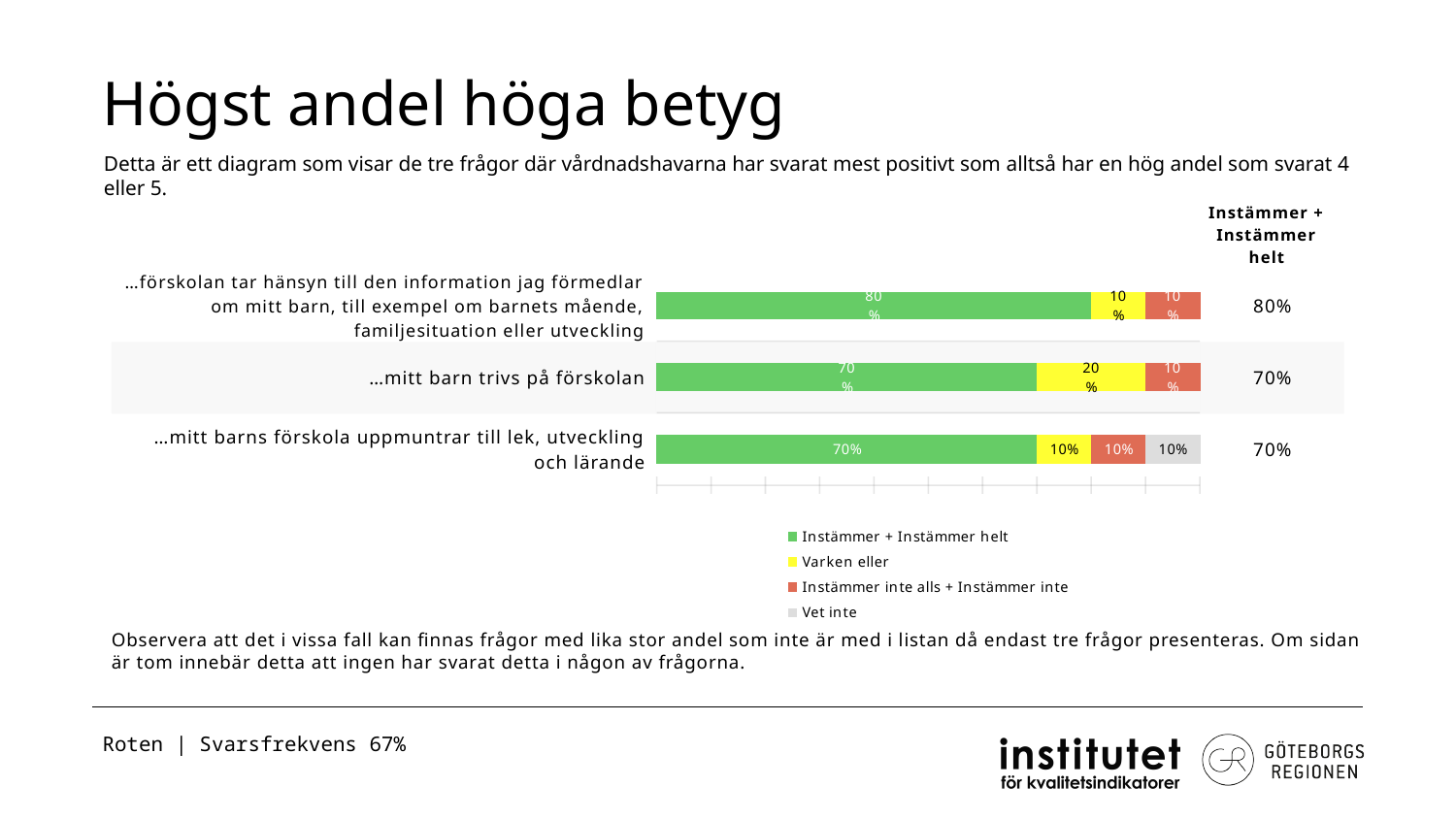
What is the 'Varken eller' share for '…mitt barn trivs på förskolan'? 20% Which question has the highest 'Instämmer + Instämmer helt' share? …förskolan tar hänsyn till den information jag förmedlar om mitt barn, till exempel om barnets mående, familjesituation eller utveckling What is the difference in 'Varken eller' share between '…mitt barn trivs på förskolan' and '…mitt barns förskola uppmuntrar till lek, utveckling och lärande'? 10% What is the total of the stacked bar for '…mitt barns förskola uppmuntrar till lek, utveckling och lärande'? 100% Which is larger: the 'Instämmer + Instämmer helt' share for '…förskolan tar hänsyn till den information jag förmedlar…' or for '…mitt barn trivs på förskolan'? …förskolan tar hänsyn till den information jag förmedlar… What kind of chart is shown on the slide? stacked bar chart What colour represents 'Instämmer inte alls + Instämmer inte' in the legend? red/orange How many series does the legend list? 4 What is the 'Vet inte' share for '…mitt barns förskola uppmuntrar till lek, utveckling och lärande'? 10% What is the 'Instämmer + Instämmer helt' share for '…förskolan tar hänsyn till den information jag förmedlar om mitt barn, till exempel om barnets mående, familjesituation eller utveckling'? 80% What is the 'Instämmer + Instämmer helt' share for '…mitt barn trivs på förskolan'? 70% How many questions (categories) are shown in the chart? 3